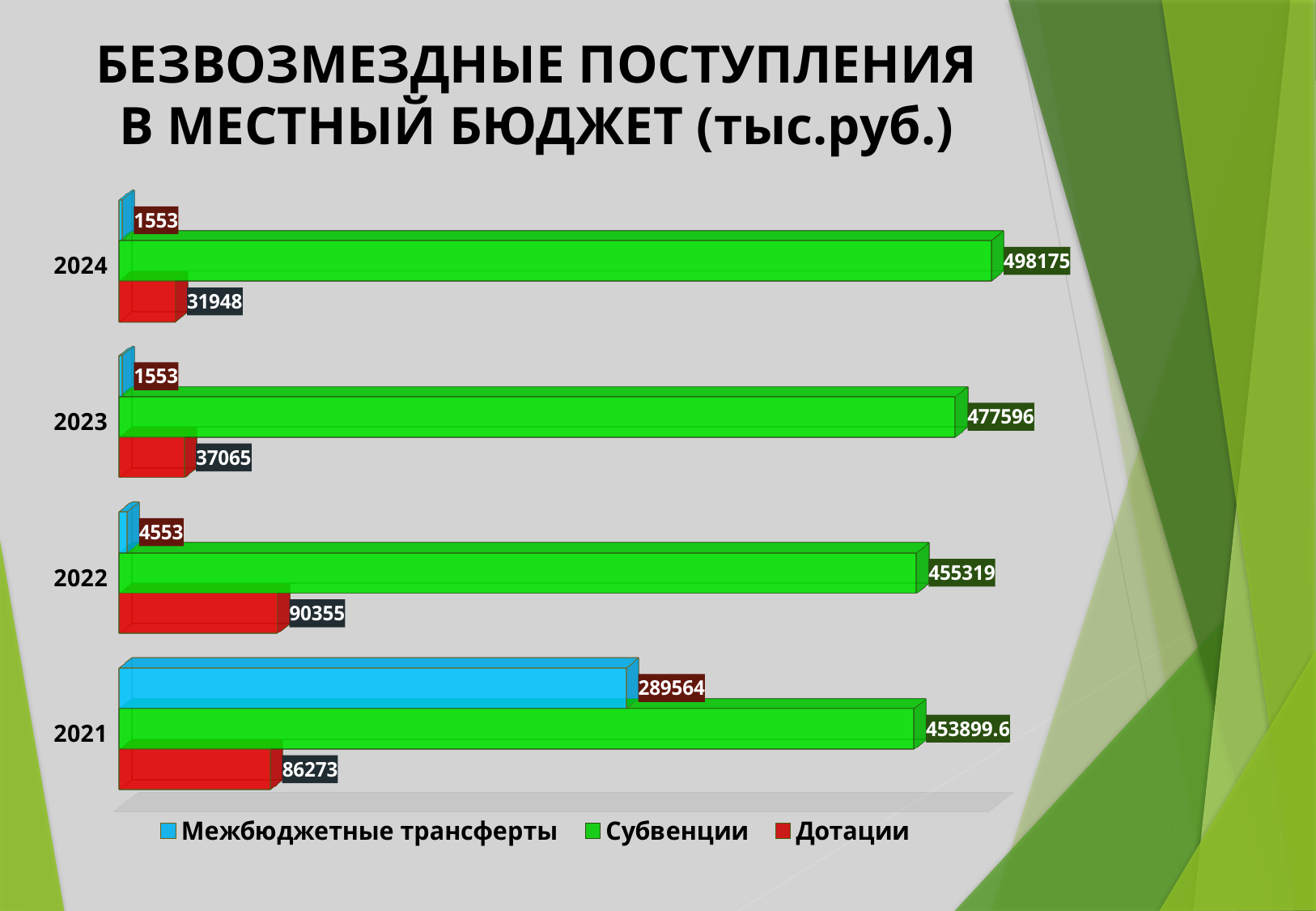
What is the value of Субвенции for 2021? 453899.6 What is the value of Межбюджетные трансферты for 2021? 289564 Which year has the highest value for Субвенции? 2024 What kind of chart is shown on the slide? Bar chart What is the value of Субвенции for 2024? 498175 Which colour represents Субвенции in the legend? Green Which year has the lowest value for Дотации? 2024 Which is larger: Дотации in 2022 or Дотации in 2021? Дотации in 2022 What is the difference between Субвенции in 2024 and in 2023? 20579 How many series does the legend list? 3 How many years are shown on the chart? 4 What is the value of Дотации for 2022? 90355